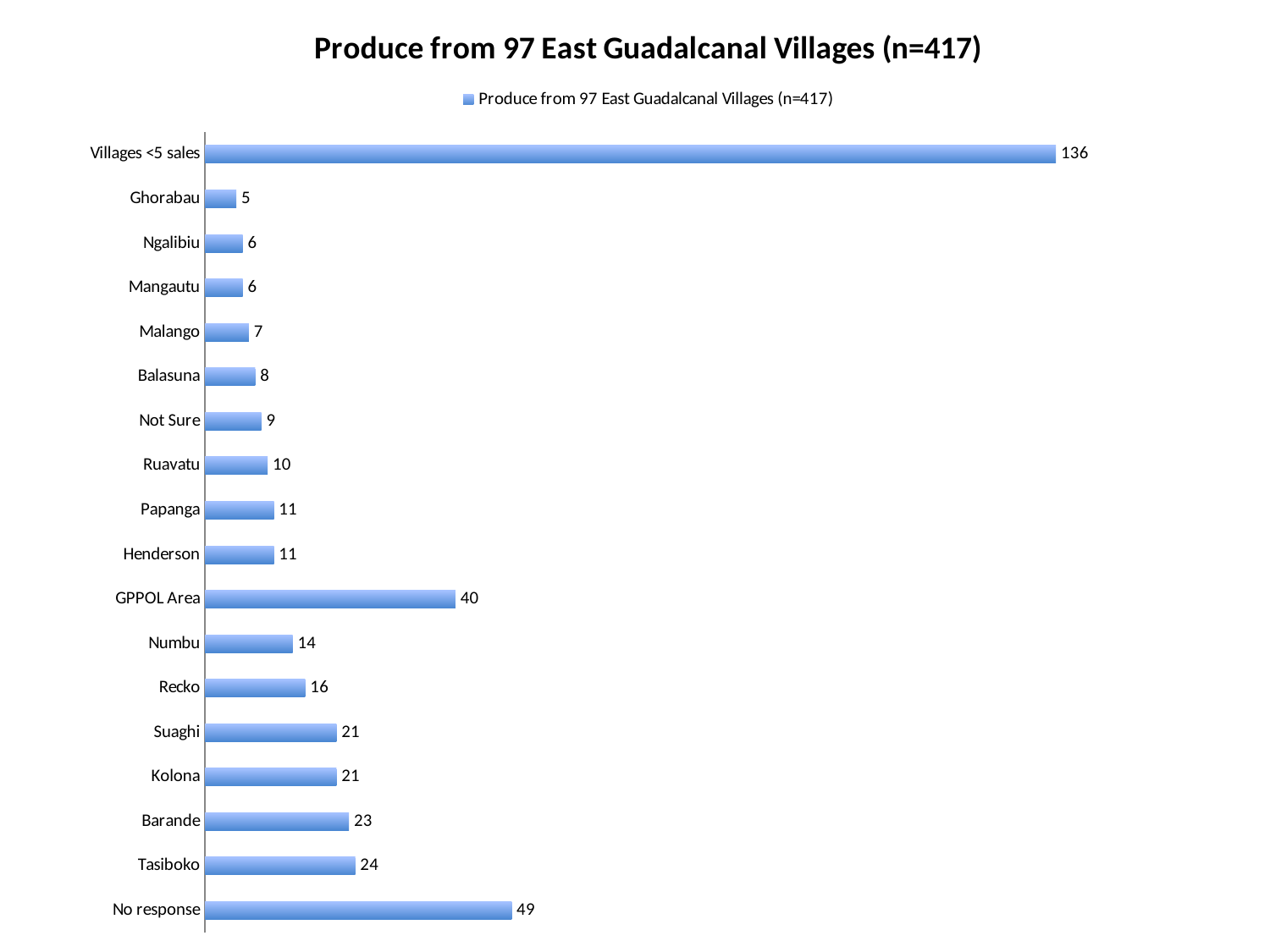
What is the value for Villages <5 sales? 136 What is the difference between the values for No response and GPPOL Area? 9 What kind of chart is shown on the slide? Bar chart Which category has the lowest value? Ghorabau What is the title of the chart? Produce from 97 East Guadalcanal Villages (n=417) What is the value for No response? 49 Which is larger, the value for Barande or the value for Recko? Barande Which category has the highest value? Villages <5 sales What is the difference between the values for Villages <5 sales and No response? 87 How many categories are shown in the chart? 18 What is the value for GPPOL Area? 40 What is the value for Tasiboko? 24